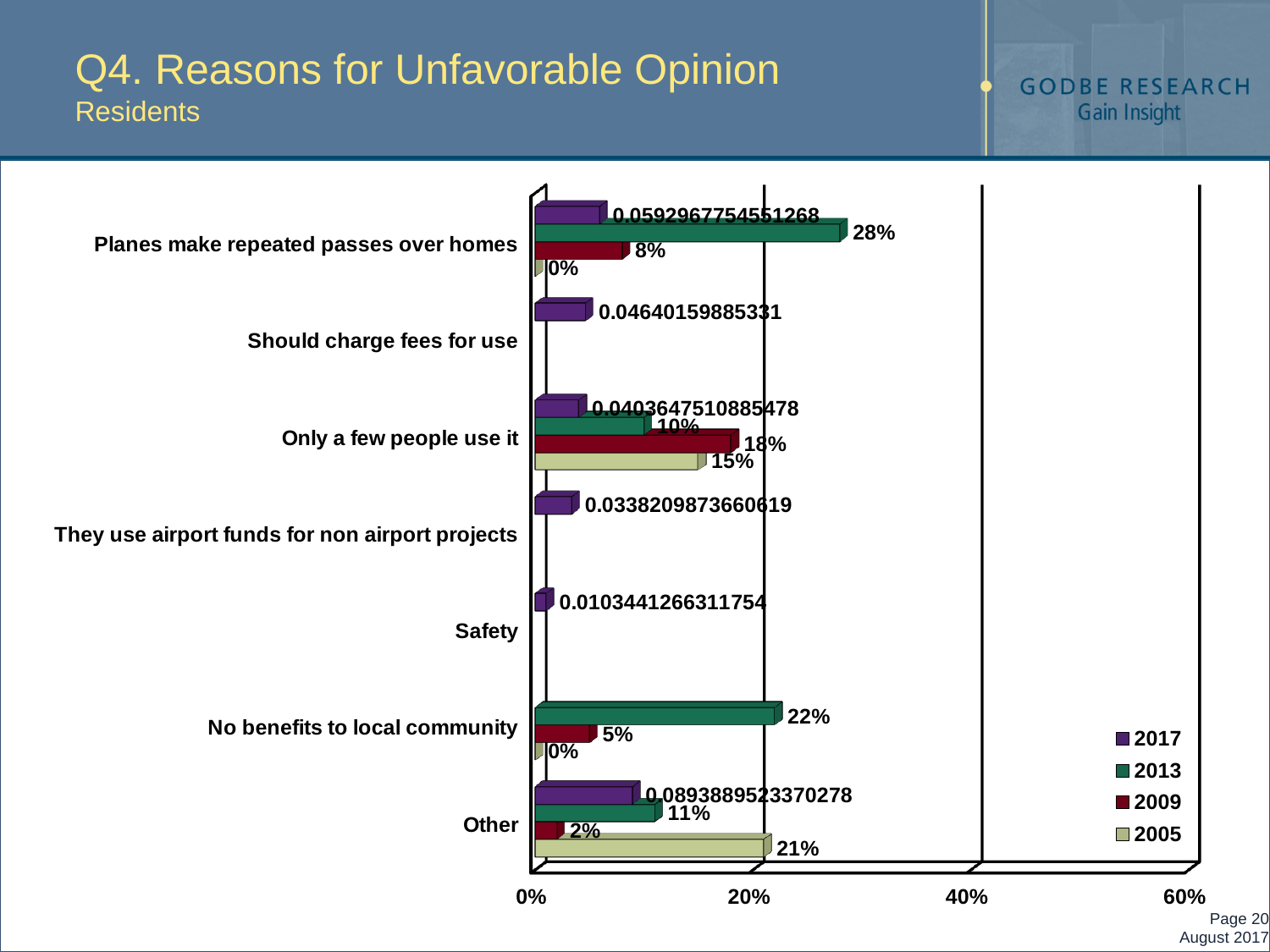
What is the difference between the 2009 and 2005 values in the 'Only a few people use it' category? 3 percentage points What is the value for 2005 in the 'Other' category? 21% What is the value for 2013 in the 'Planes make repeated passes over homes' category? 28% What data label is shown for the 2017 bar in the 'Safety' category? 0.0103441266311754 Is the 2013 value for 'Planes make repeated passes over homes' greater or less than 20%? greater What is the value for 2009 in the 'Only a few people use it' category? 18% Which category has the lowest labelled value for the 2009 series? Other How many categories are shown on the chart? 7 Which is larger for 2013: 'No benefits to local community' or 'Other'? No benefits to local community What kind of chart is shown on the slide? Bar chart How many series does the legend list? 4 Which category has the highest value for the 2013 series? Planes make repeated passes over homes